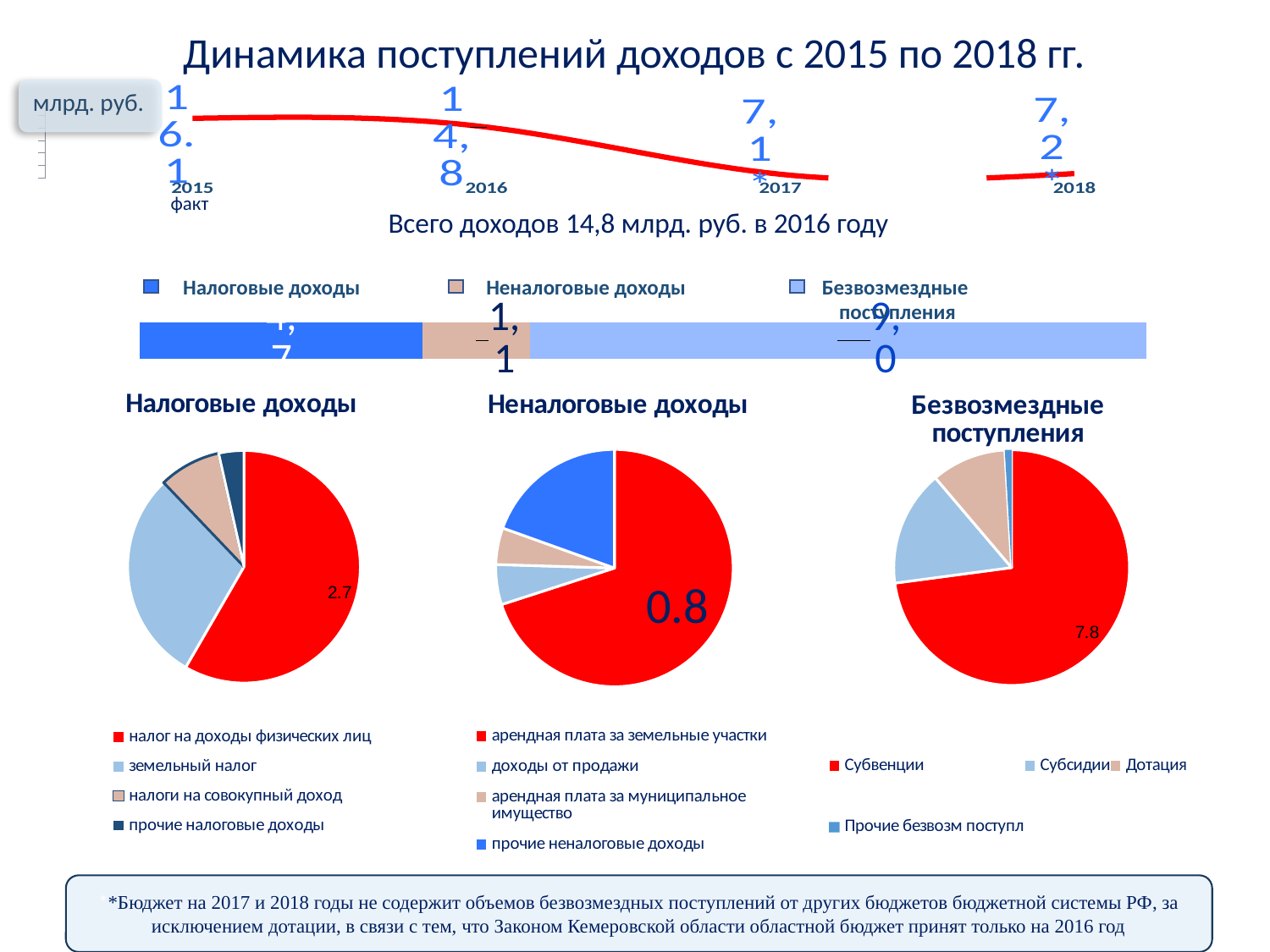
In the pie chart titled Безвозмездные поступления, what is the value of the Субвенции slice? 7.8 In the top line chart, do the values rise or fall from 2015 to 2017? fall What kind of chart is the top chart showing the years 2015 to 2018? line chart In the pie chart titled Налоговые доходы, what is the value of the налог на доходы физических лиц slice? 2.7 How many series does the legend of the horizontal stacked bar list? 3 In the horizontal stacked bar, what is the value for Безвозмездные поступления? 9,0 How many categories does the legend of the pie chart titled Безвозмездные поступления list? 4 In the top line chart, which year has the highest value? 2015 In the top line chart, what is the value for 2016? 14,8 In the horizontal stacked bar, what is the value for Неналоговые доходы? 1,1 In the top line chart, what is the value for 2018? 7,2 In the pie chart titled Неналоговые доходы, which category has the largest slice? арендная плата за земельные участки